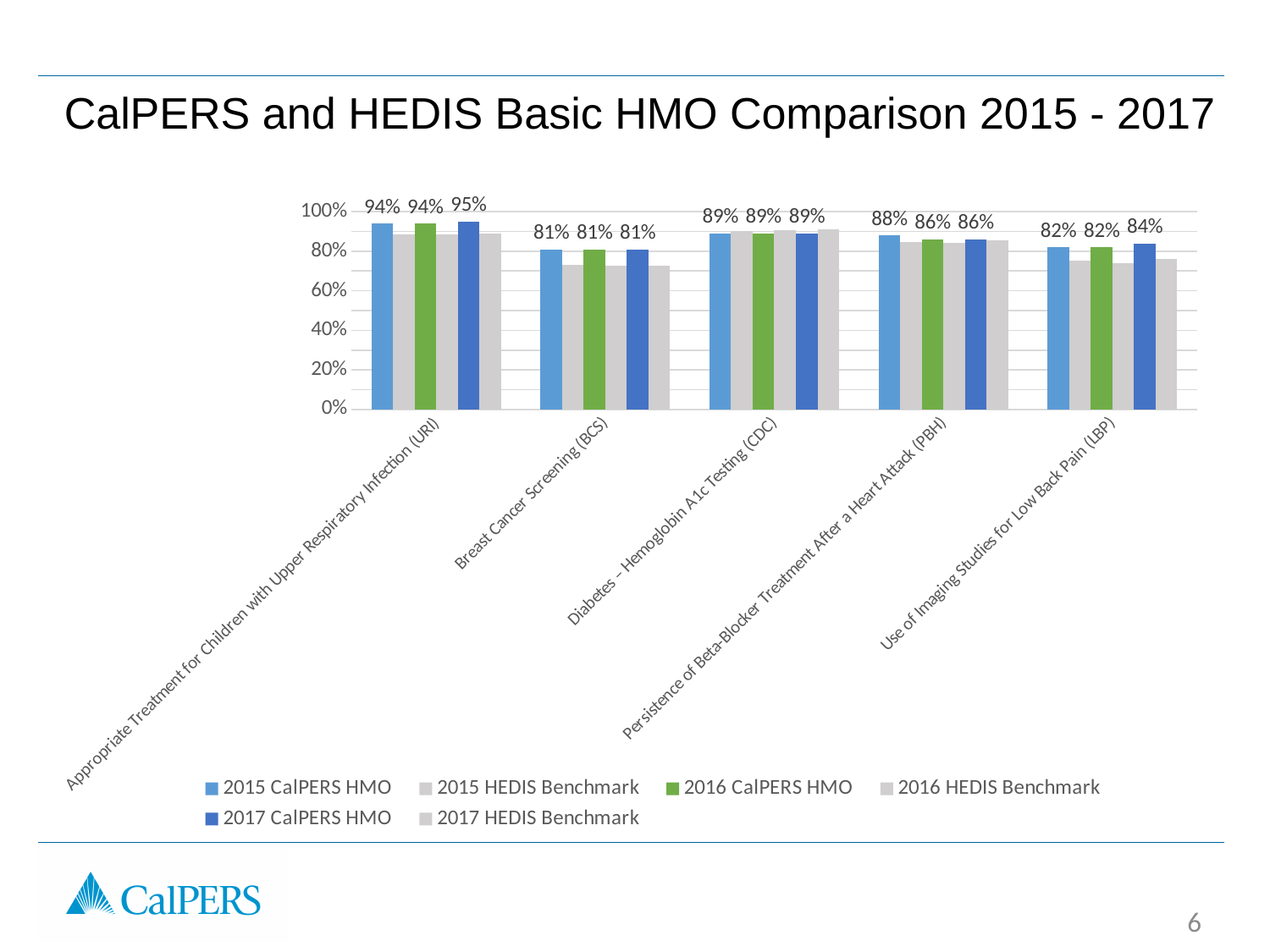
What type of chart is shown on the slide? bar chart How many measure categories are shown along the x axis? 5 Which category has the lowest 2015 CalPERS HMO value? Breast Cancer Screening (BCS) What is the 2015 CalPERS HMO value for Persistence of Beta-Blocker Treatment After a Heart Attack (PBH)? 88% What is the 2016 CalPERS HMO value for Breast Cancer Screening (BCS)? 81% Is the 2015 HEDIS Benchmark value for Breast Cancer Screening (BCS) greater or less than 80%? less How many series does the legend list? 6 What is the title of the chart? CalPERS and HEDIS Basic HMO Comparison 2015 - 2017 What is the 2017 CalPERS HMO value for Appropriate Treatment for Children with Upper Respiratory Infection (URI)? 95% Which category has the highest 2017 CalPERS HMO value? Appropriate Treatment for Children with Upper Respiratory Infection (URI) What is the difference between the 2015 CalPERS HMO value and the 2017 CalPERS HMO value for Persistence of Beta-Blocker Treatment After a Heart Attack (PBH)? 2% What is the 2017 CalPERS HMO value for Use of Imaging Studies for Low Back Pain (LBP)? 84%